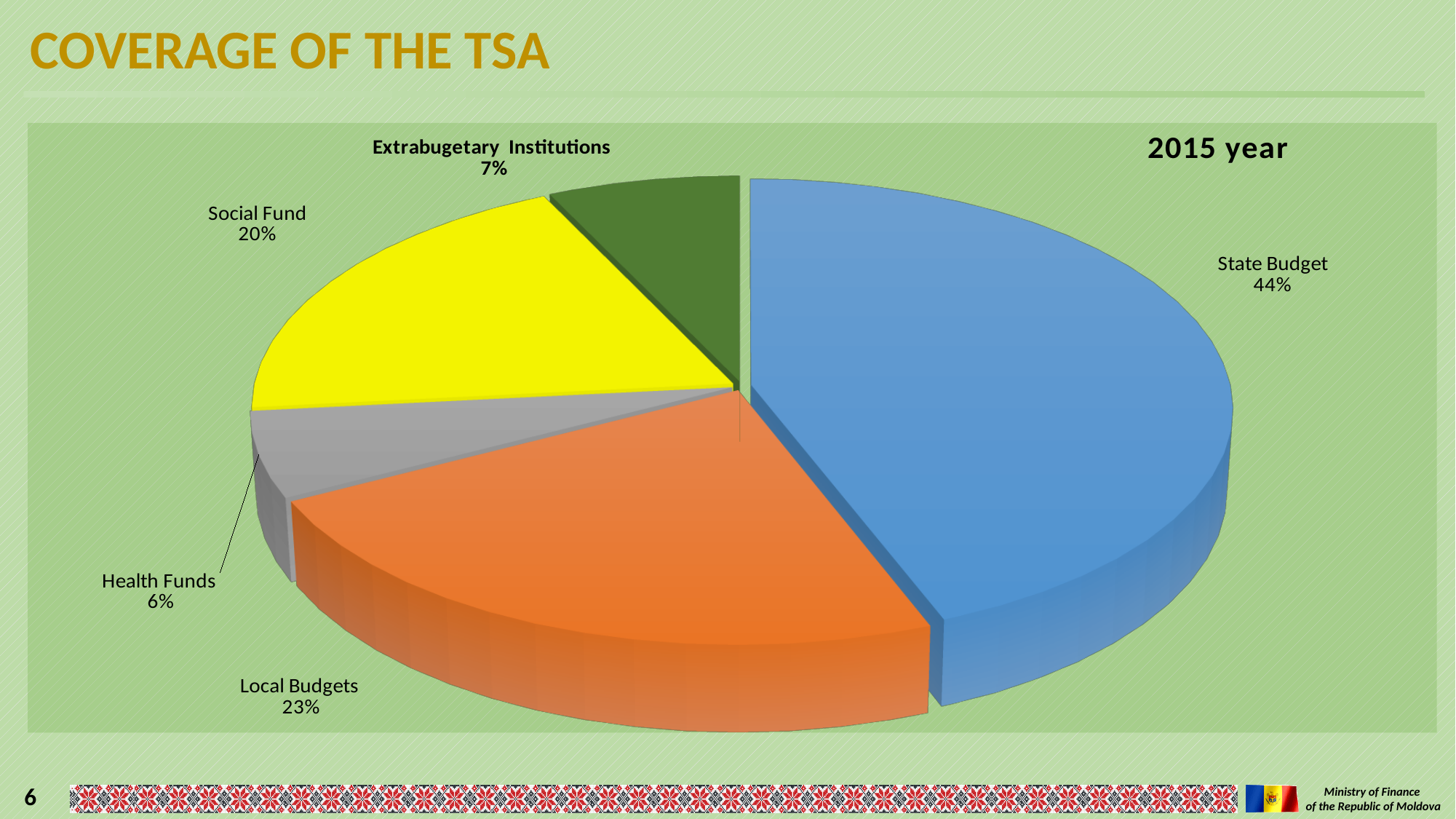
What share of the pie does State Budget represent? 44% What is the value shown for Social Fund? 20% Which category has the smallest slice of the pie? Health Funds What is the value shown for Extrabugetary Institutions? 7% What is the value shown for Health Funds? 6% Which category has the largest slice of the pie? State Budget What is the difference between the State Budget share and the Local Budgets share? 21% Which year does the chart refer to, according to the label in the chart? 2015 year What is the value shown for Local Budgets? 23% What kind of chart is shown on the slide? Pie chart How many slices does the pie chart have? 5 Which is larger, the Social Fund share or the Local Budgets share? Local Budgets